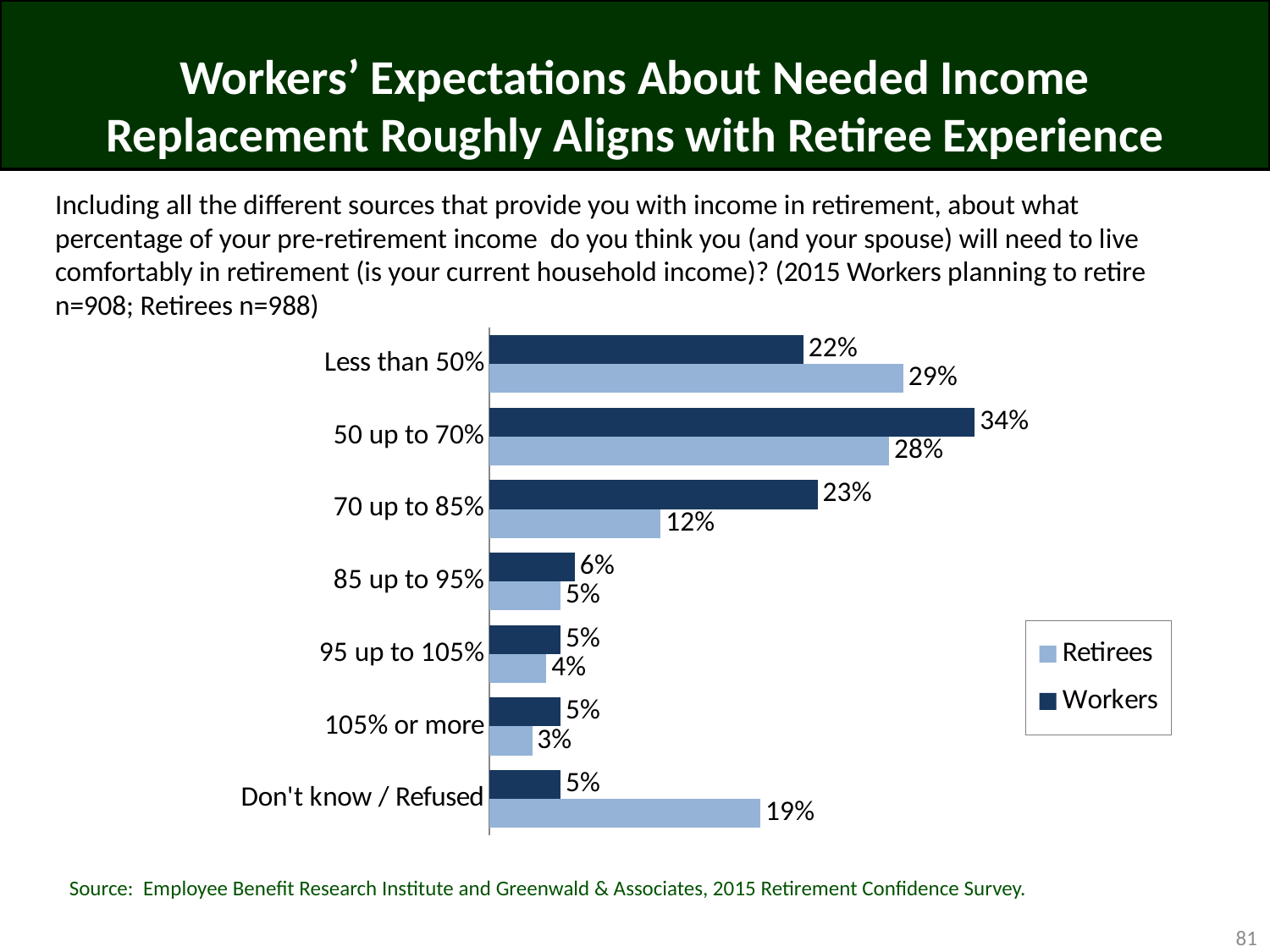
What is the value for Retirees in the 70 up to 85% category? 12% What percentage of Retirees answered Don't know / Refused? 19% Which series is shown in the darker blue colour? Workers What is the difference between the Retirees and Workers values for Don't know / Refused? 14 percentage points Which category has the highest value for Workers? 50 up to 70% Which category has the lowest value for Retirees? 105% or more What is the difference between the Workers and Retirees values for 70 up to 85%? 11 percentage points How many categories are shown on the chart? 7 How many series does the legend list? 2 What percentage of Workers said they will need 50 up to 70% of their pre-retirement income? 34% For the Less than 50% category, which series has the larger value, Workers or Retirees? Retirees What kind of chart is shown on the slide? Bar chart